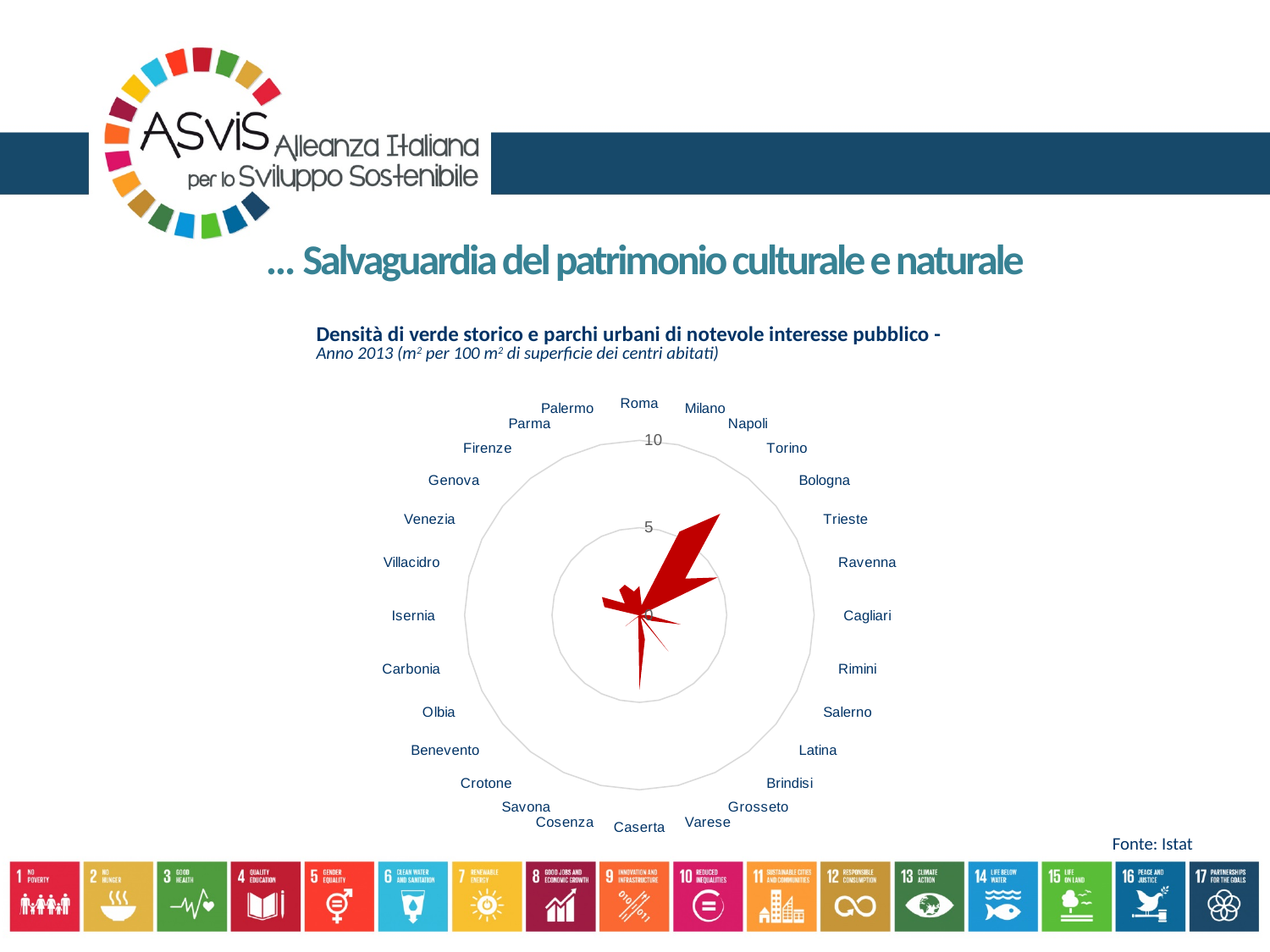
Which city has the highest value on the radar chart? Torino Which has the larger value, Torino or Isernia? Torino What is the data source cited for the chart? Istat Is the value for Isernia greater or less than 5? less Which has the larger value, Torino or Carbonia? Torino What is the title of the chart? Densità di verde storico e parchi urbani di notevole interesse pubblico Is the value for Olbia greater or less than 5? less How many cities are plotted around the radar chart? 28 Is the value for Torino greater or less than 5? greater What kind of chart is shown on the slide? radar chart